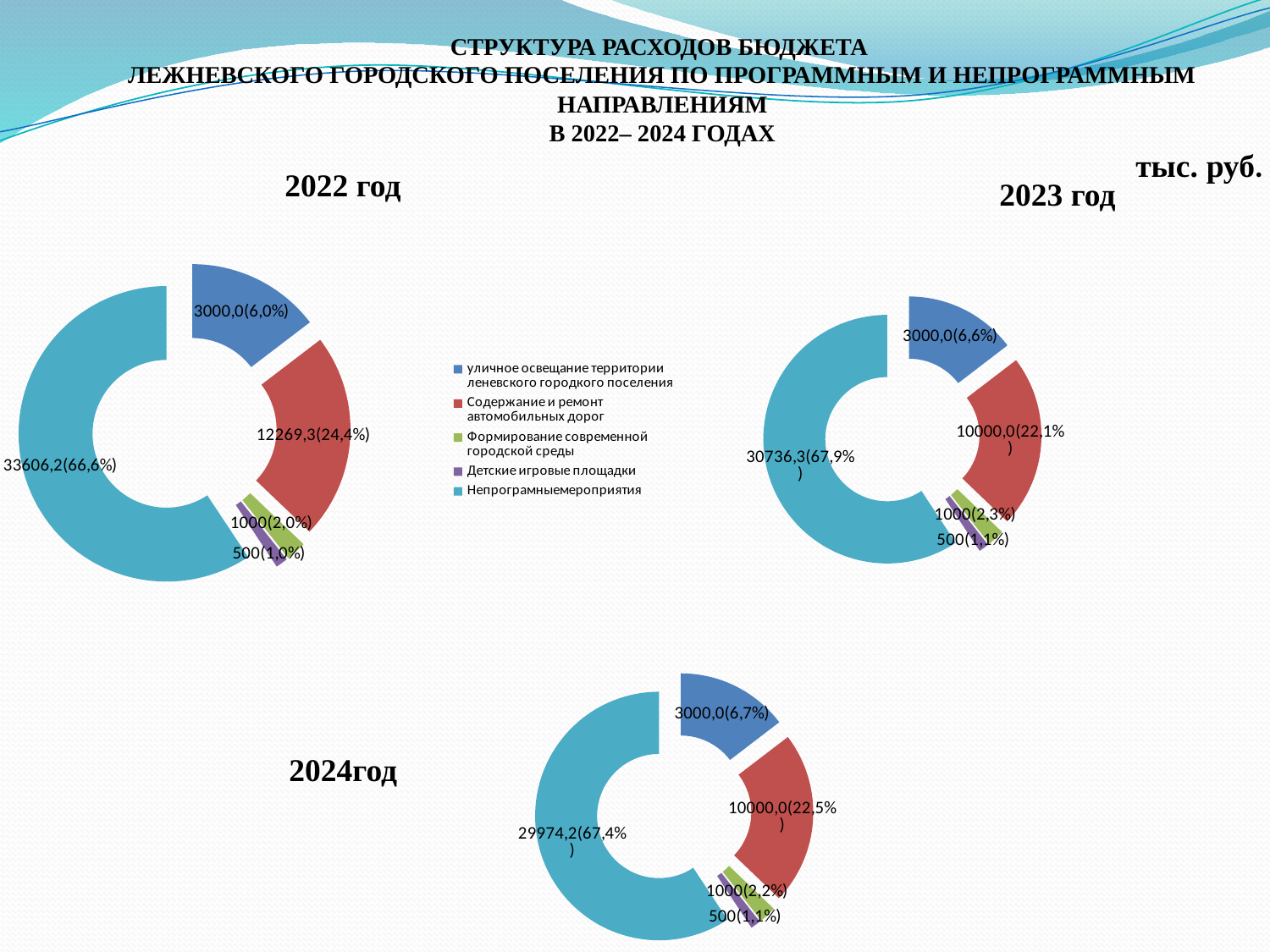
What colour represents Непрограмные мероприятия in the legend? teal (light blue) How many slices does the 2024 год chart have? 5 In the 2024 год chart, what share of the total does Непрограмные мероприятия account for? 67,4% In the 2023 год chart, which is larger: уличное освещение территории or Формирование современной городской среды? уличное освещение территории In the 2022 год chart, what share of the total does Содержание и ремонт автомобильных дорог account for? 24,4% In the 2022 год chart, which category has the largest slice? Непрограмные мероприятия In the 2024 год chart, what value is shown for уличное освещение территории? 3000,0(6,7%) In the 2023 год chart, what value is shown for Содержание и ремонт автомобильных дорог? 10000,0(22,1%) What kind of chart is used for 2022 год? doughnut (pie) chart In the 2023 год chart, which category has the smallest slice? Детские игровые площадки In the 2022 год chart, what value is shown for Непрограмные мероприятия? 33606,2(66,6%) How many series does the legend list? 5